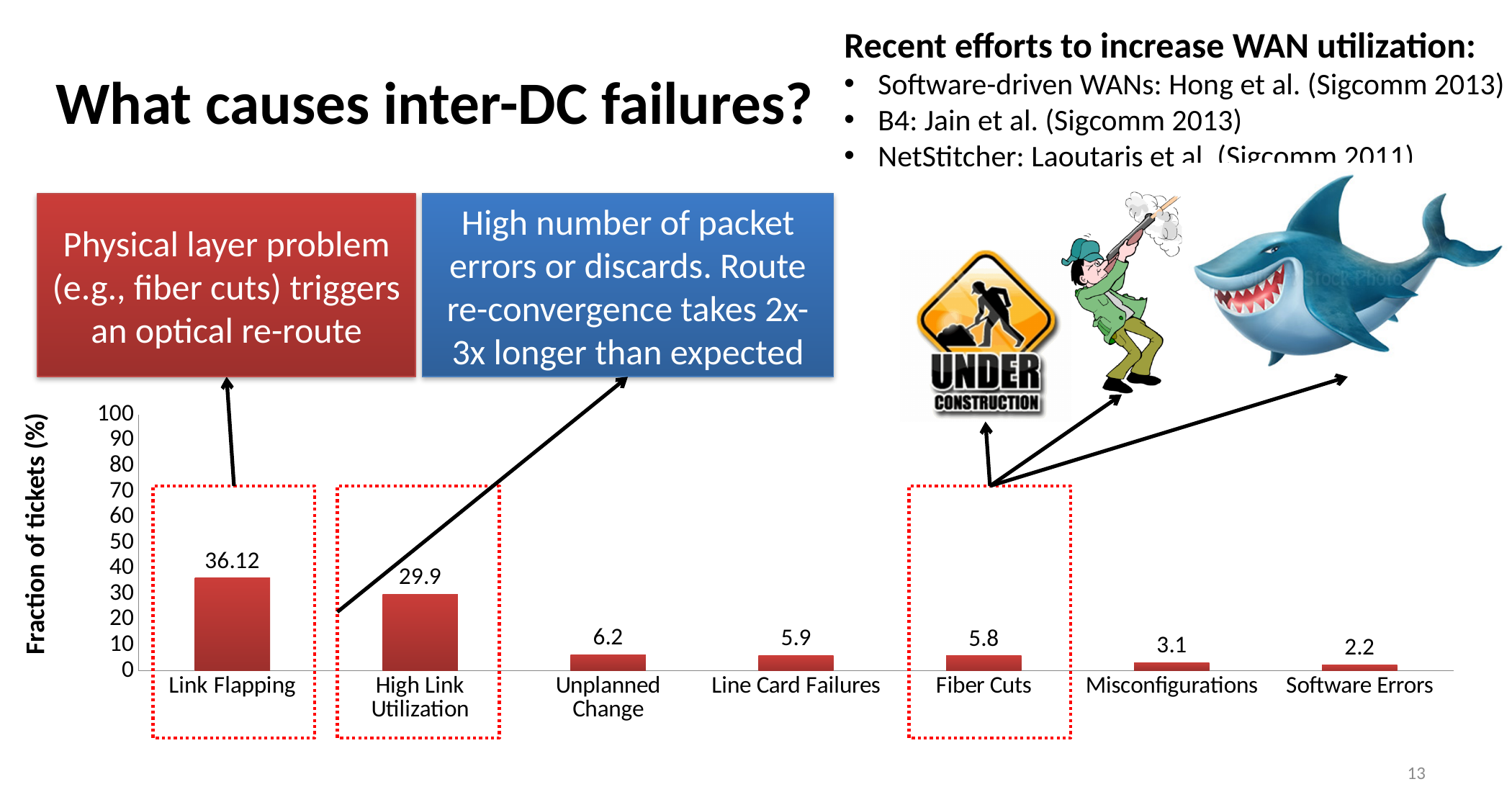
Which category has the highest fraction of tickets? Link Flapping How many categories are shown on the x axis? 7 Is the value for Link Flapping greater or less than 30? greater What is the value for High Link Utilization? 29.9 What is the value for Software Errors? 2.2 Which is larger, the value for Unplanned Change or the value for Misconfigurations? Unplanned Change What is the value for Link Flapping? 36.12 What is the label of the y axis? Fraction of tickets (%) Which category has the lowest fraction of tickets? Software Errors What is the value for Fiber Cuts? 5.8 What is the difference between the values for Link Flapping and High Link Utilization? 6.22 What kind of chart is shown on the slide? bar chart